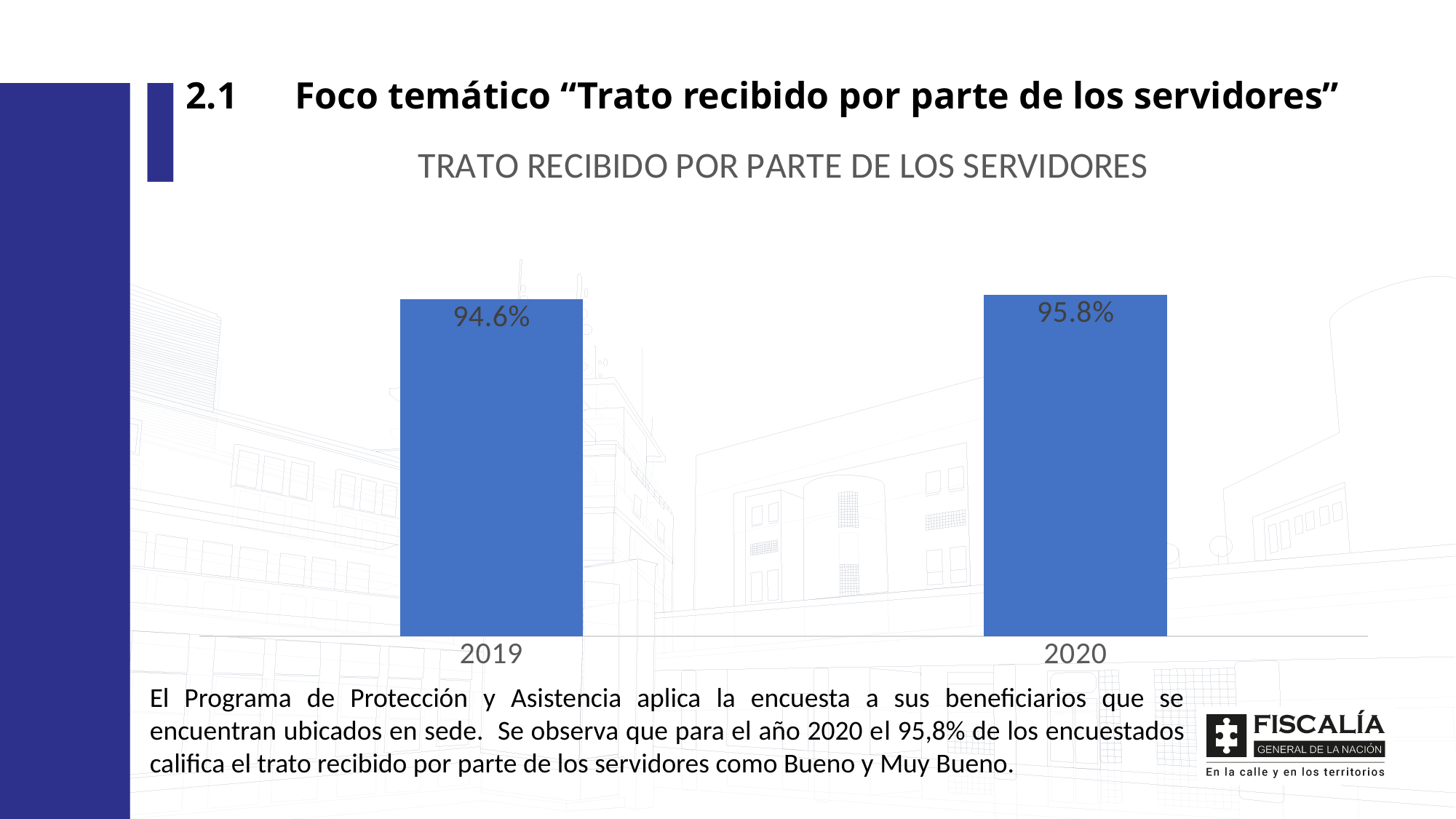
Is the value for 2020 larger than the value for 2019? Yes Which year has the lower value? 2019 What is the title of the chart? TRATO RECIBIDO POR PARTE DE LOS SERVIDORES Do the values rise or fall from 2019 to 2020? Rise Which year has the higher value? 2020 What kind of chart is shown? Bar chart What is the value for 2020? 95.8% What is the value for 2019? 94.6% What colour are the bars? Blue How many categories are shown on the x axis? 2 What is the difference between the 2020 and 2019 values? 1.2%